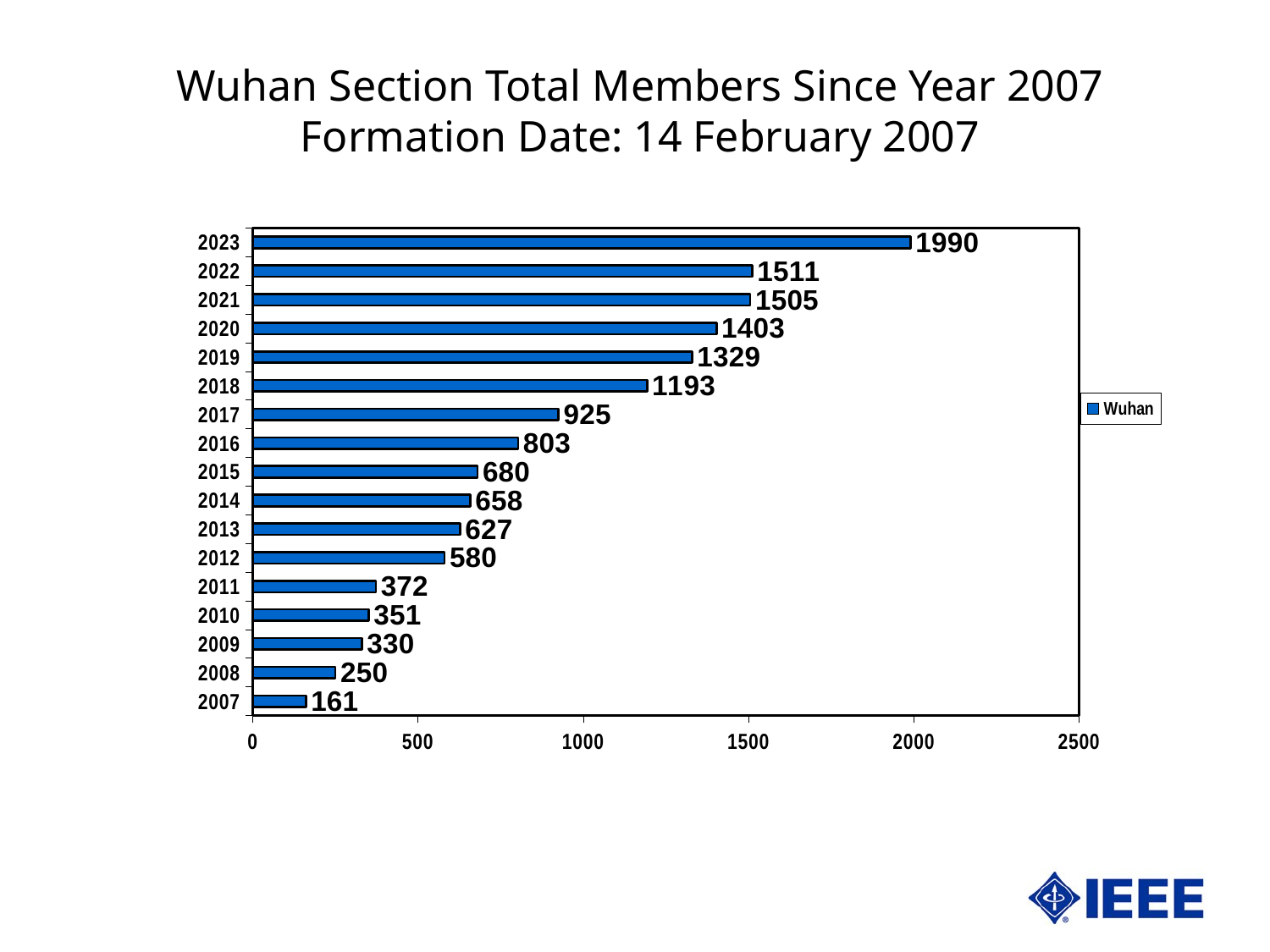
What kind of chart is shown on the slide? bar chart What is the total number of Wuhan Section members in 2023? 1990 What series name appears in the legend? Wuhan How many years are shown on the chart? 17 Which year has more members, 2018 or 2017? 2018 What is the value shown for 2012? 580 How many series does the legend list? 1 Do the member counts rise or fall from 2007 to 2023? rise Is the value for 2019 greater or less than 1000? greater Which year has the lowest number of members? 2007 Which year has the highest number of members? 2023 What is the difference between the 2023 value and the 2022 value? 479